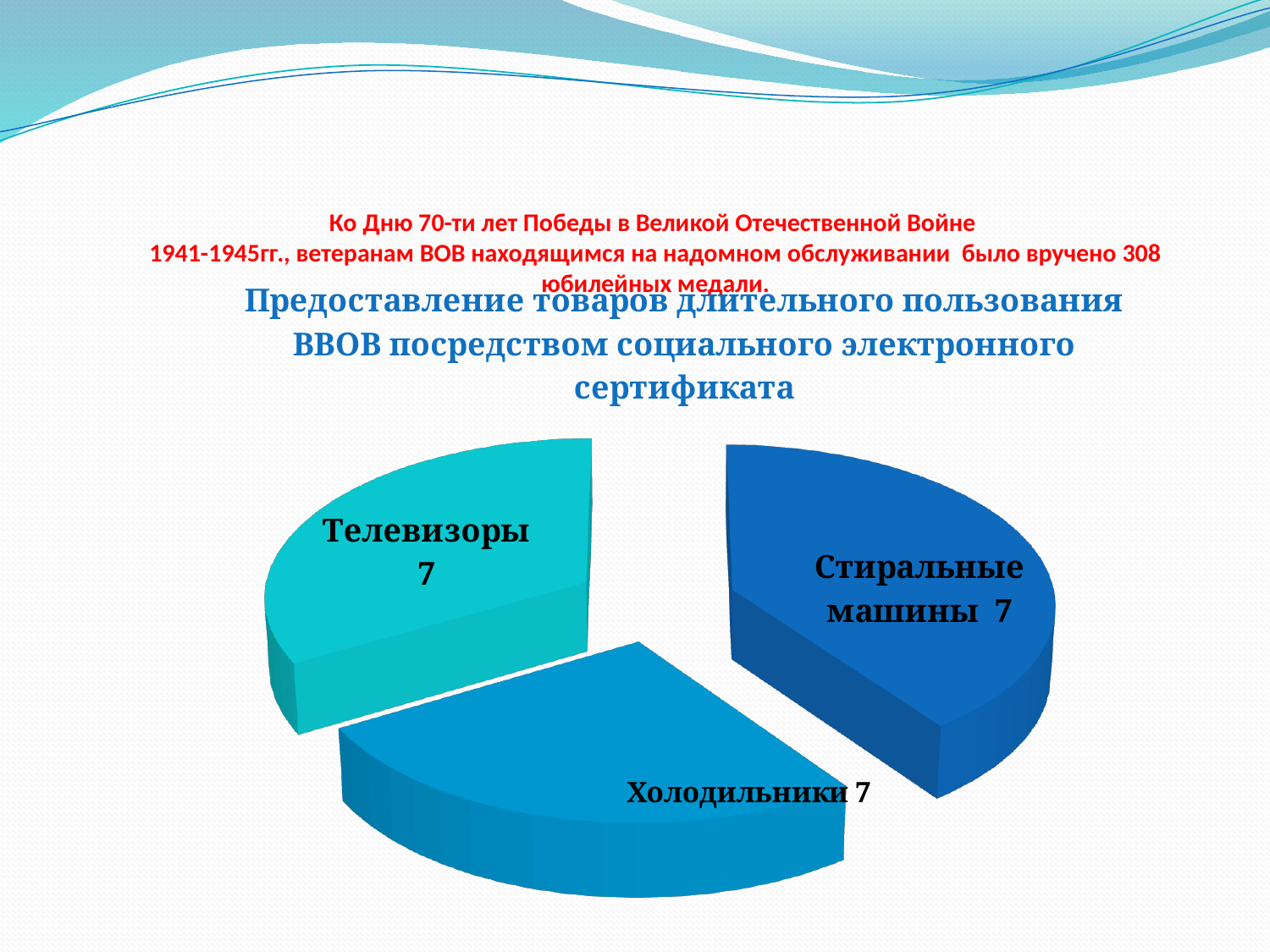
What is the title of the chart? Предоставление товаров длительного пользования ВВОВ посредством социального электронного сертификата Which category is shown in the darkest blue slice? Стиральные машины How many slices does the pie chart have? 3 What kind of chart is shown on the slide? Pie chart What is the total of all the values shown in the pie chart? 21 What value is shown for the Холодильники slice? 7 Is the value for Телевизоры larger than, smaller than, or equal to the value for Холодильники? Equal What value is shown for the Стиральные машины slice? 7 What value is shown for the Телевизоры slice of the pie chart? 7 Is the value for Стиральные машины larger than, smaller than, or equal to the value for Телевизоры? Equal